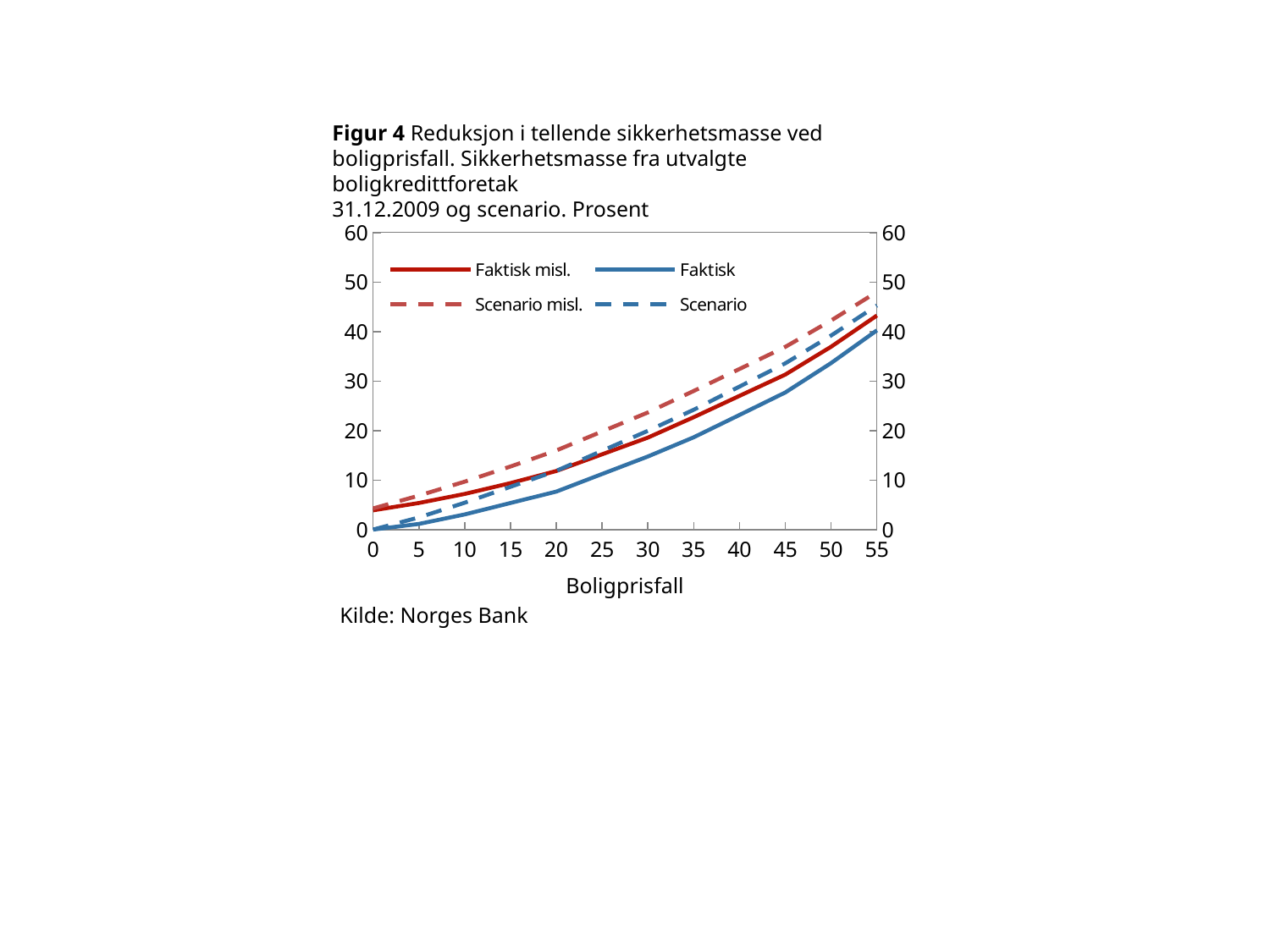
Is the value for Faktisk misl. at a Boligprisfall of 20 greater or less than 20? less How many series does the legend list? 4 What kind of chart is shown on the slide? line chart Is the value for Scenario misl. at a Boligprisfall of 55 greater or less than 40? greater At a Boligprisfall of 0, which is larger: Faktisk misl. or Faktisk? Faktisk misl. Do the values of the Faktisk series rise or fall as Boligprisfall increases? rise Which series has the lowest value at a Boligprisfall of 55? Faktisk Which series has the highest value at a Boligprisfall of 55? Scenario misl. Do the values of the Scenario misl. series rise or fall along the x axis? rise What source is given for the chart? Norges Bank Is the value for Faktisk at a Boligprisfall of 55 greater or less than 30? greater What is the label of the x axis? Boligprisfall